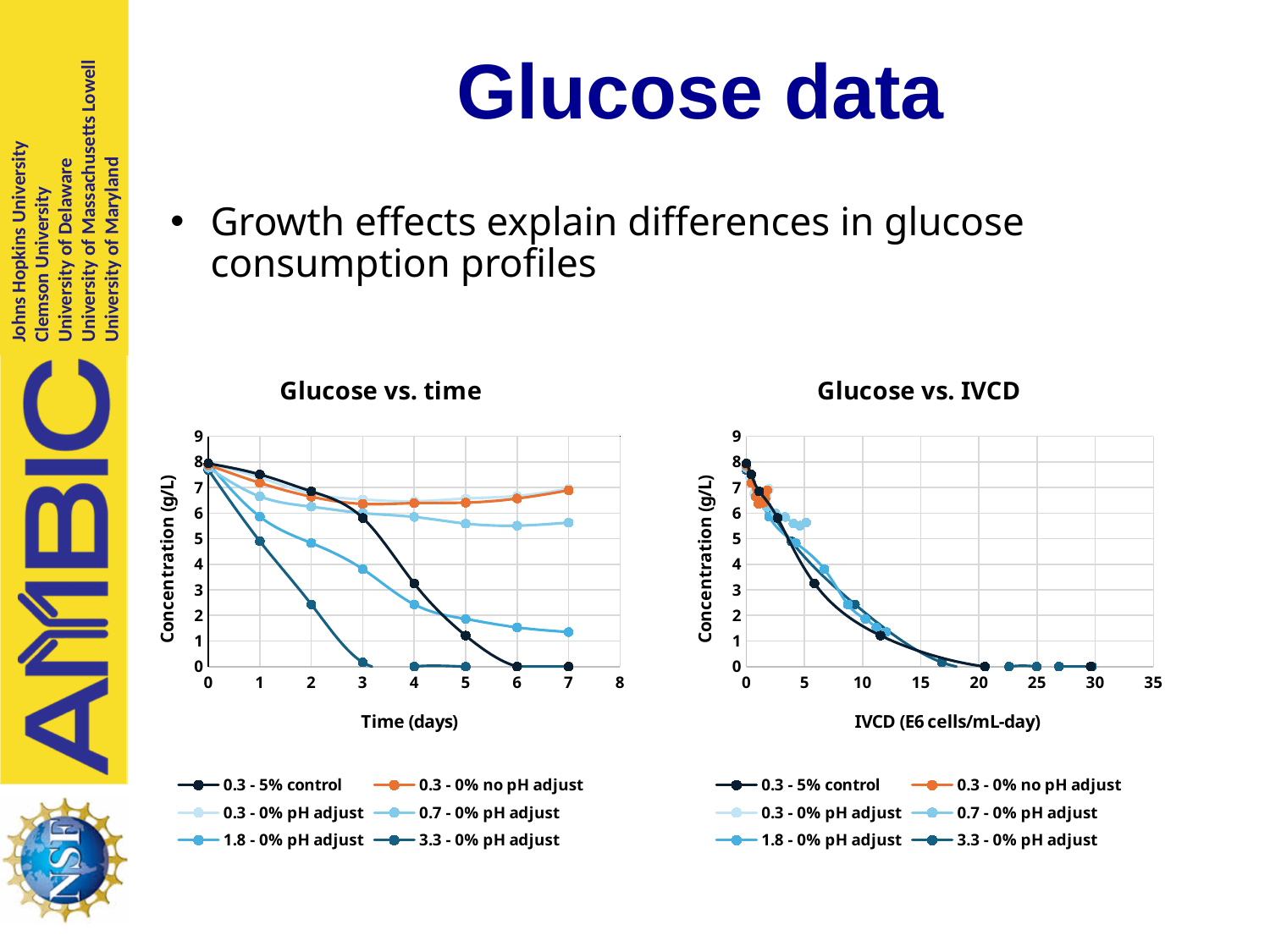
What is the x-axis label of the "Glucose vs. IVCD" chart? IVCD (E6 cells/mL-day) What kind of chart is the "Glucose vs. time" chart? Line chart In the "Glucose vs. time" chart, what is the concentration for the 0.3 - 5% control series at day 7? 0 In the "Glucose vs. time" chart, does the 0.3 - 5% control series rise or fall over time? Fall In the "Glucose vs. time" chart, is the value for 0.3 - 5% control at day 4 greater or less than 4? less What is the y-axis label of the "Glucose vs. time" chart? Concentration (g/L) In the "Glucose vs. time" chart, at day 3, which is larger: 0.7 - 0% pH adjust or 3.3 - 0% pH adjust? 0.7 - 0% pH adjust In the "Glucose vs. time" chart, is the value for 0.3 - 0% no pH adjust at day 7 greater or less than 6? greater In the "Glucose vs. time" chart, is the value for 1.8 - 0% pH adjust at day 7 greater or less than 2? less In the "Glucose vs. time" chart, at day 7, which is larger: 0.3 - 0% no pH adjust or 1.8 - 0% pH adjust? 0.3 - 0% no pH adjust How many series does the legend of the "Glucose vs. IVCD" chart list? 6